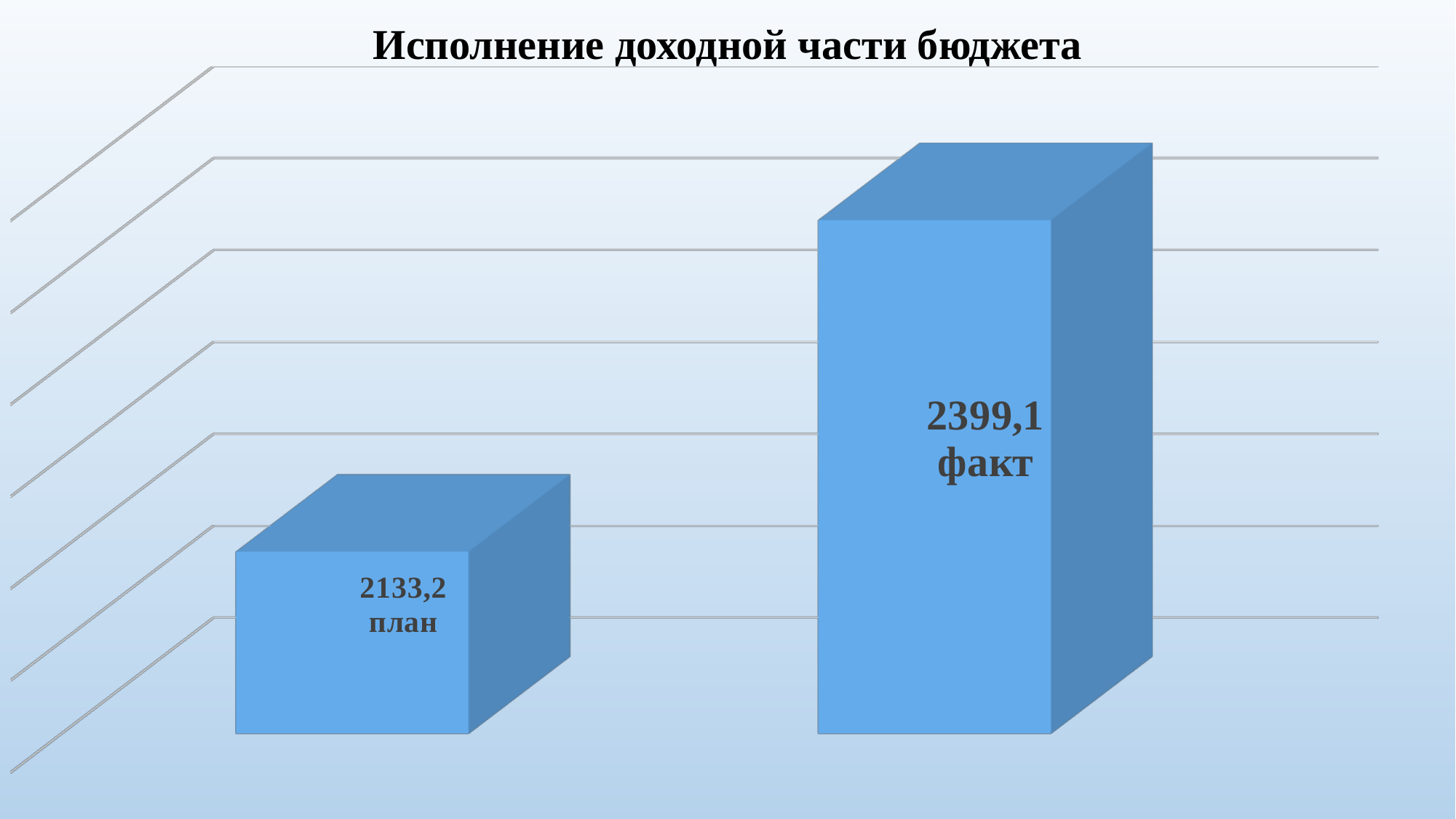
Which category has the lowest value? план Do the values rise or fall from план to факт? rise Which is larger, the value for план or the value for факт? факт What colour are the bars in the chart? blue What is the value for план (plan)? 2133,2 What is the difference between the факт and план values? 265,9 How many bars are shown in the chart? 2 What kind of chart is shown on the slide? bar chart What is the value for факт (actual)? 2399,1 Which category has the highest value? факт What is the title of the chart? Исполнение доходной части бюджета